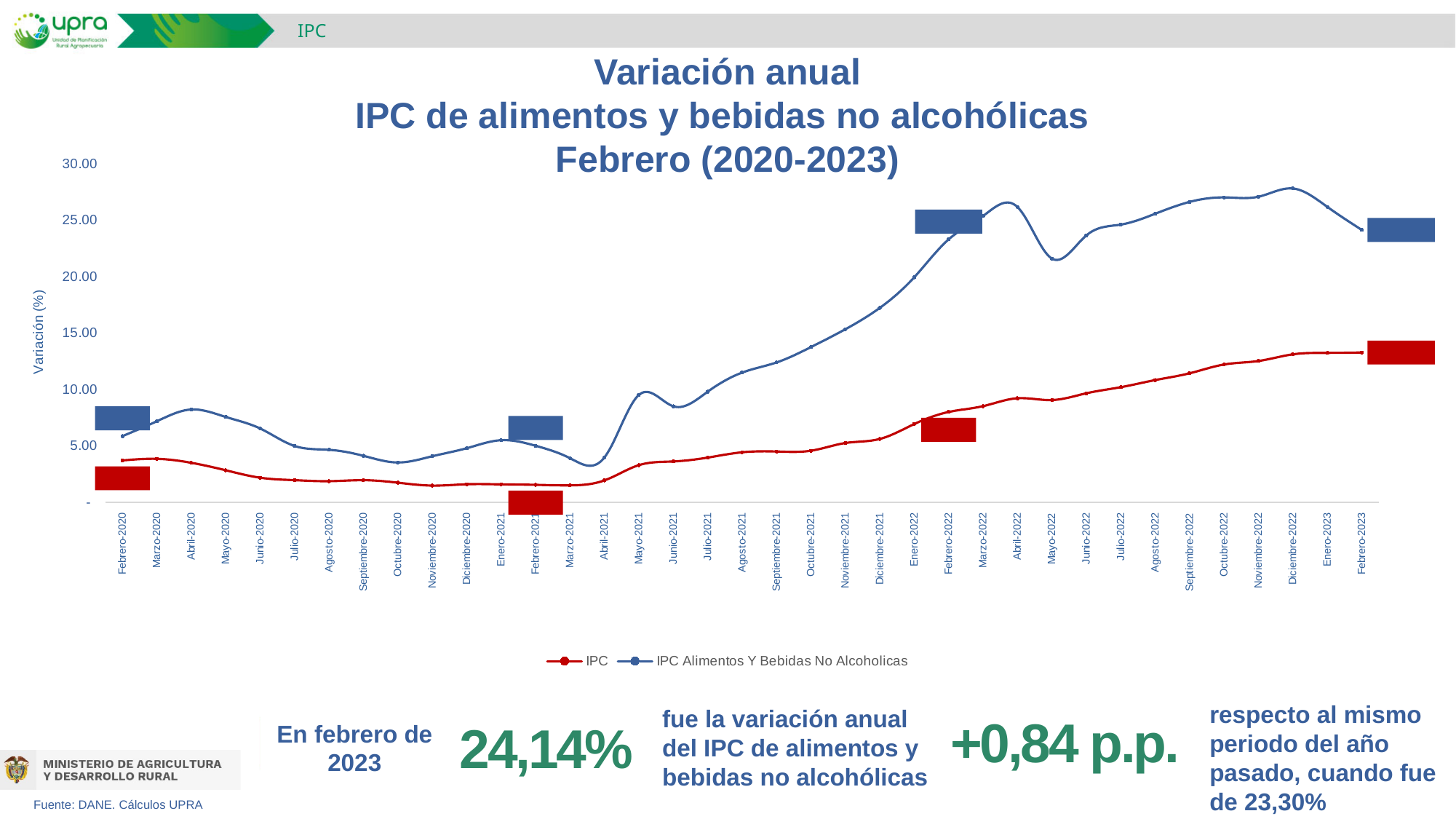
What is the annual variation of the IPC de alimentos y bebidas no alcohólicas in Febrero-2023, as stated on the slide? 24,14% Which series is drawn in red according to the legend? IPC What was the annual variation of the IPC de alimentos y bebidas no alcohólicas in Febrero-2022, as stated on the slide? 23,30% By how many percentage points did the annual variation of the IPC de alimentos y bebidas no alcohólicas in Febrero-2023 differ from Febrero-2022? +0,84 p.p. How many series does the legend list? 2 Is the value of IPC in Febrero-2023 greater or less than 10.00? greater Is the value of IPC Alimentos Y Bebidas No Alcoholicas in Diciembre-2022 greater or less than 25.00? greater Is the value of IPC Alimentos Y Bebidas No Alcoholicas in Abril-2021 greater or less than 5.00? less In Febrero-2023, which series has the larger value: IPC or IPC Alimentos Y Bebidas No Alcoholicas? IPC Alimentos Y Bebidas No Alcoholicas Does the IPC series generally rise or fall from Abril-2021 to Febrero-2023? rise What kind of chart is shown on the slide? line chart In which month is the IPC Alimentos Y Bebidas No Alcoholicas series at its highest? Diciembre-2022